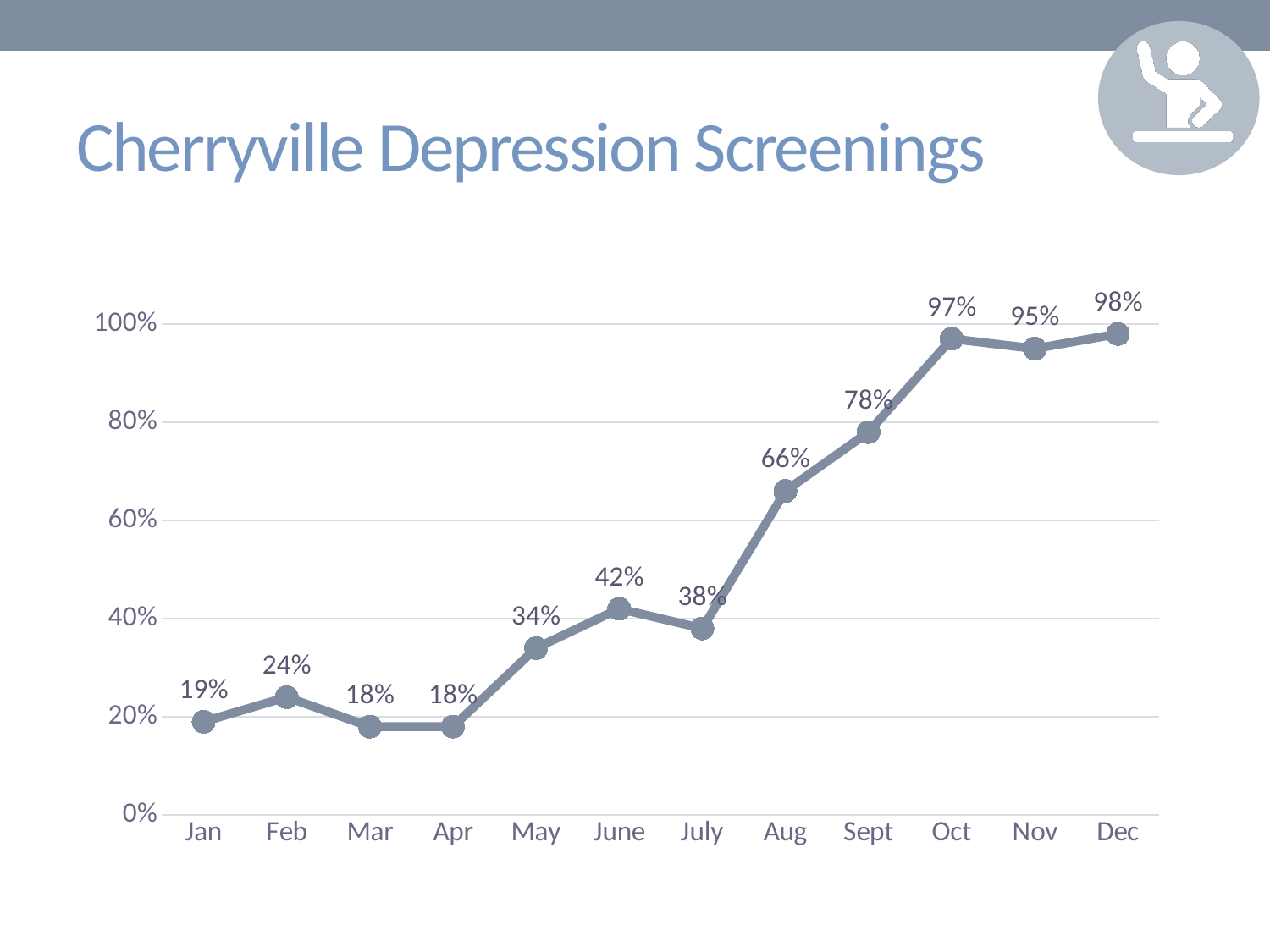
Do the values generally rise or fall from Jan to Dec? rise What is the value for Sept? 78% What is the value for Jan? 19% Which months share the lowest value? Mar and Apr What is the title of the slide? Cherryville Depression Screenings Is the value for May greater or less than 40%? less Which month has the highest value? Dec Which is larger, the value for June or the value for July? June How many months are plotted on the x axis? 12 What is the difference between the values for Oct and Jan? 78% What is the value for Aug? 66% What kind of chart is shown? line chart